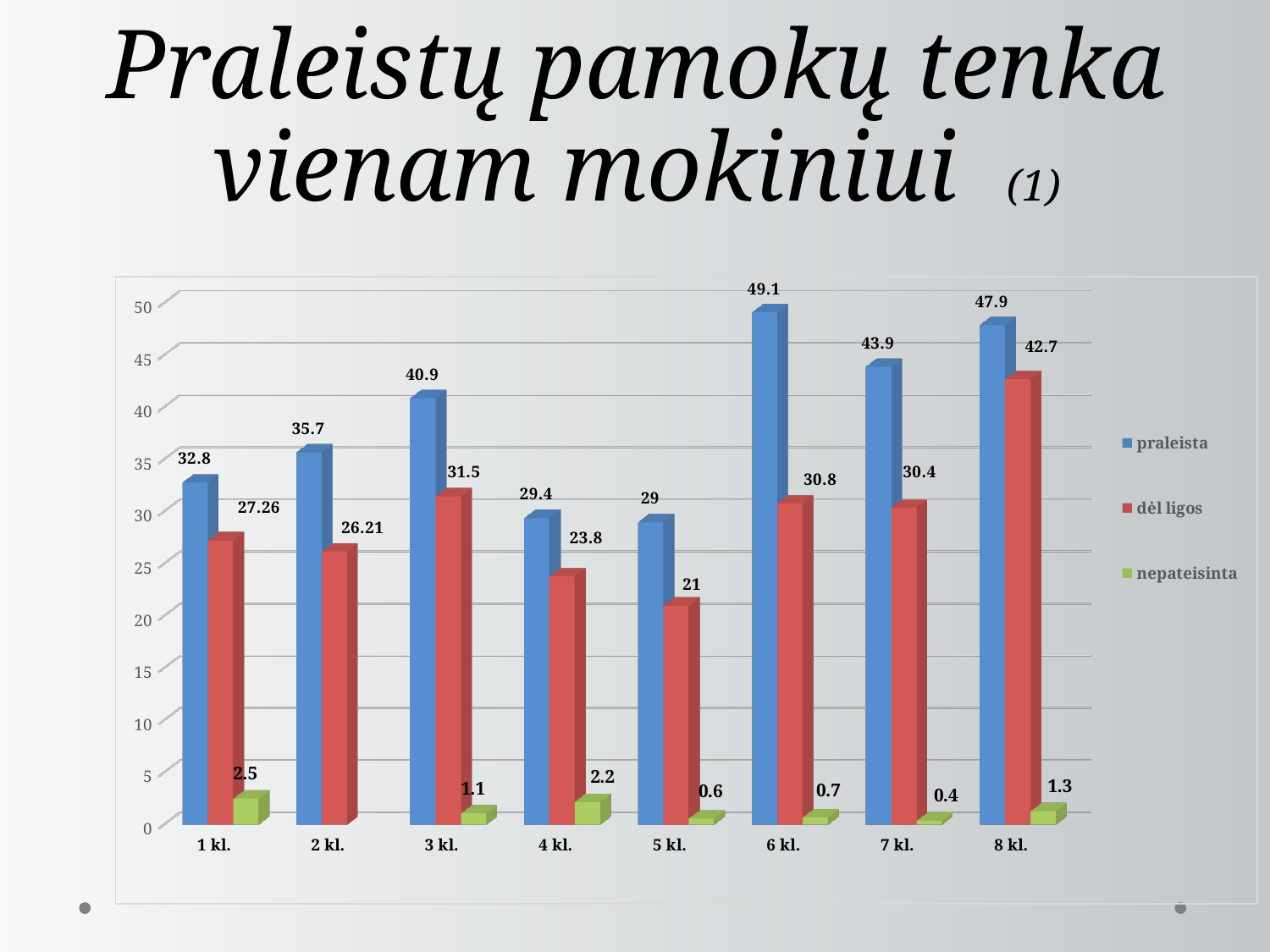
How many classes are shown on the x axis? 8 What is the 'nepateisinta' value for 4 kl.? 2.2 Which class has the highest 'praleista' value? 6 kl. How many series does the legend list? 3 Which colour represents the 'dėl ligos' series? red What is the 'praleista' value for 3 kl.? 40.9 What kind of chart is shown on the slide? bar chart What is the 'dėl ligos' value for 1 kl.? 27.26 Which class has the lowest 'nepateisinta' value? 7 kl. What is the difference between the 'praleista' and 'dėl ligos' values for 8 kl.? 5.2 Which is larger: the 'praleista' value for 2 kl. or for 4 kl.? 2 kl. Which class has the lowest 'dėl ligos' value? 5 kl.